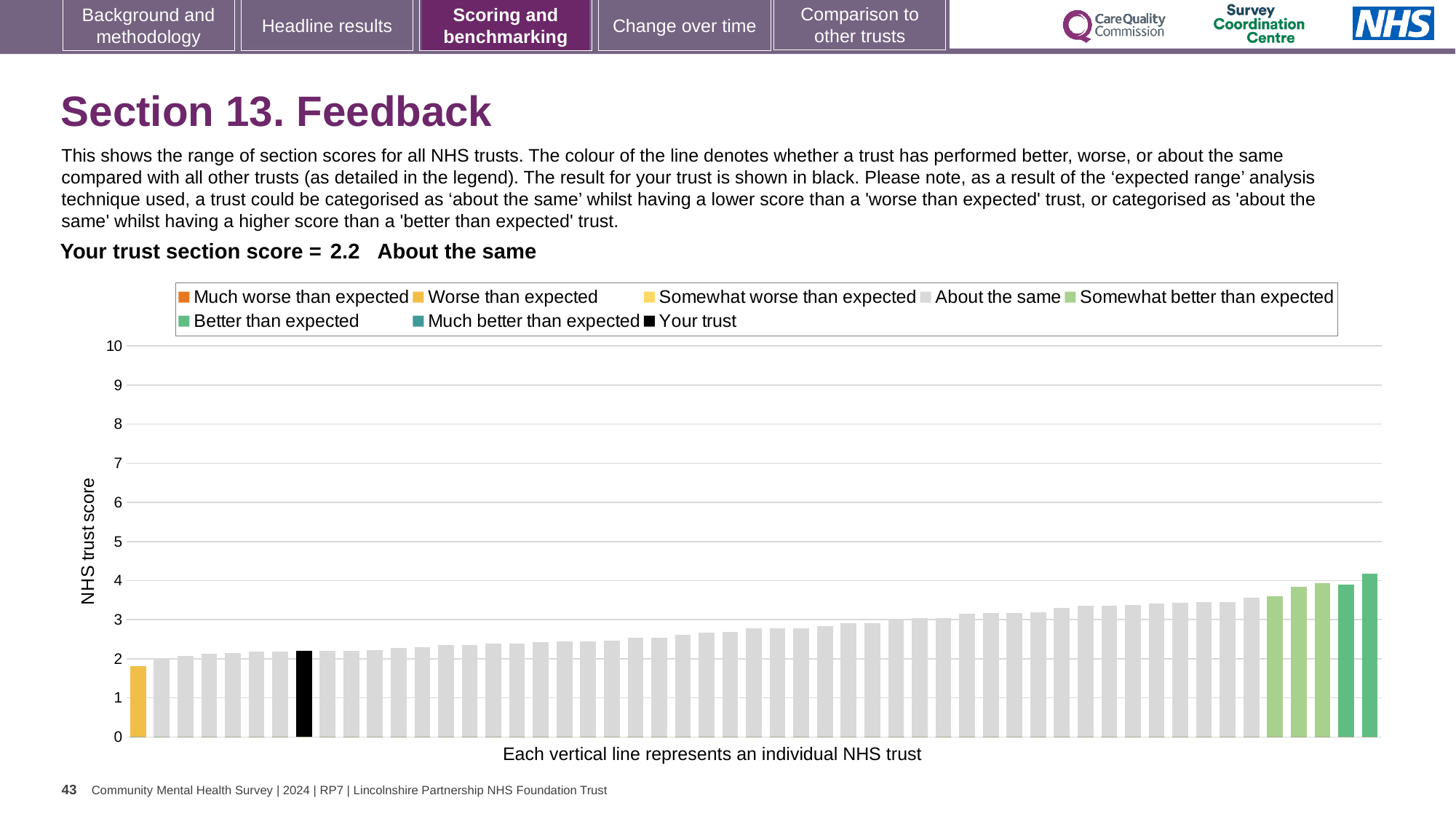
What is the label on the vertical axis of the chart? NHS trust score What colour is the bar representing your trust? black How many entries does the chart legend list? 8 Is the value for the lowest-scoring trust greater or less than 2? less Do the bar values rise or fall from left to right along the x axis? rise Is the value for your trust greater or less than 2? greater What is the highest value shown on the vertical axis? 10 What is the section score for your trust shown on the slide? 2.2 What kind of chart is shown on the slide? bar chart Is the value for the highest-scoring trust greater or less than 3? greater How is your trust's section score categorised compared with other trusts? About the same